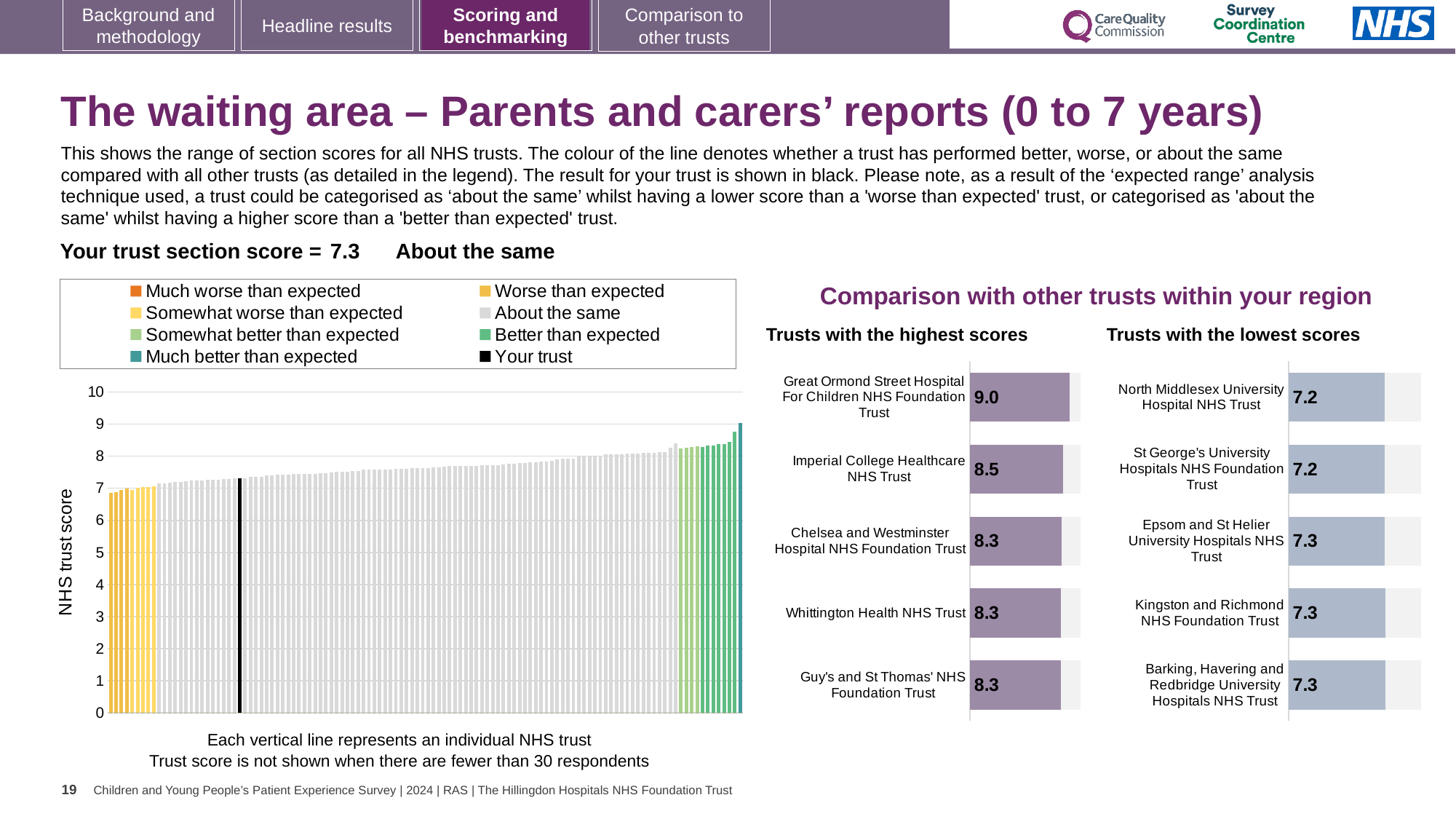
In the large chart on the left, is the value of the black bar (your trust) greater or less than 8? less In the 'Trusts with the highest scores' chart, what is the difference between the scores of Great Ormond Street Hospital For Children NHS Foundation Trust and Imperial College Healthcare NHS Trust? 0.5 How many entries does the legend above the large chart on the left list? 8 In the large chart on the left, do the bar values rise or fall from left to right? rise In the 'Trusts with the highest scores' chart, which trust has the highest score? Great Ormond Street Hospital For Children NHS Foundation Trust In the 'Trusts with the lowest scores' chart, what is the score for Barking, Havering and Redbridge University Hospitals NHS Trust? 7.3 In the 'Trusts with the highest scores' chart, what is the score for Imperial College Healthcare NHS Trust? 8.5 In the 'Trusts with the highest scores' chart, what is the score for Great Ormond Street Hospital For Children NHS Foundation Trust? 9.0 Which is larger: the score for Imperial College Healthcare NHS Trust in the 'highest scores' chart or the score for Epsom and St Helier University Hospitals NHS Trust in the 'lowest scores' chart? Imperial College Healthcare NHS Trust What kind of chart is the large chart on the left with the y axis labelled 'NHS trust score'? bar chart In the 'Trusts with the lowest scores' chart, what is the score for North Middlesex University Hospital NHS Trust? 7.2 How many trusts are shown in the 'Trusts with the lowest scores' chart? 5